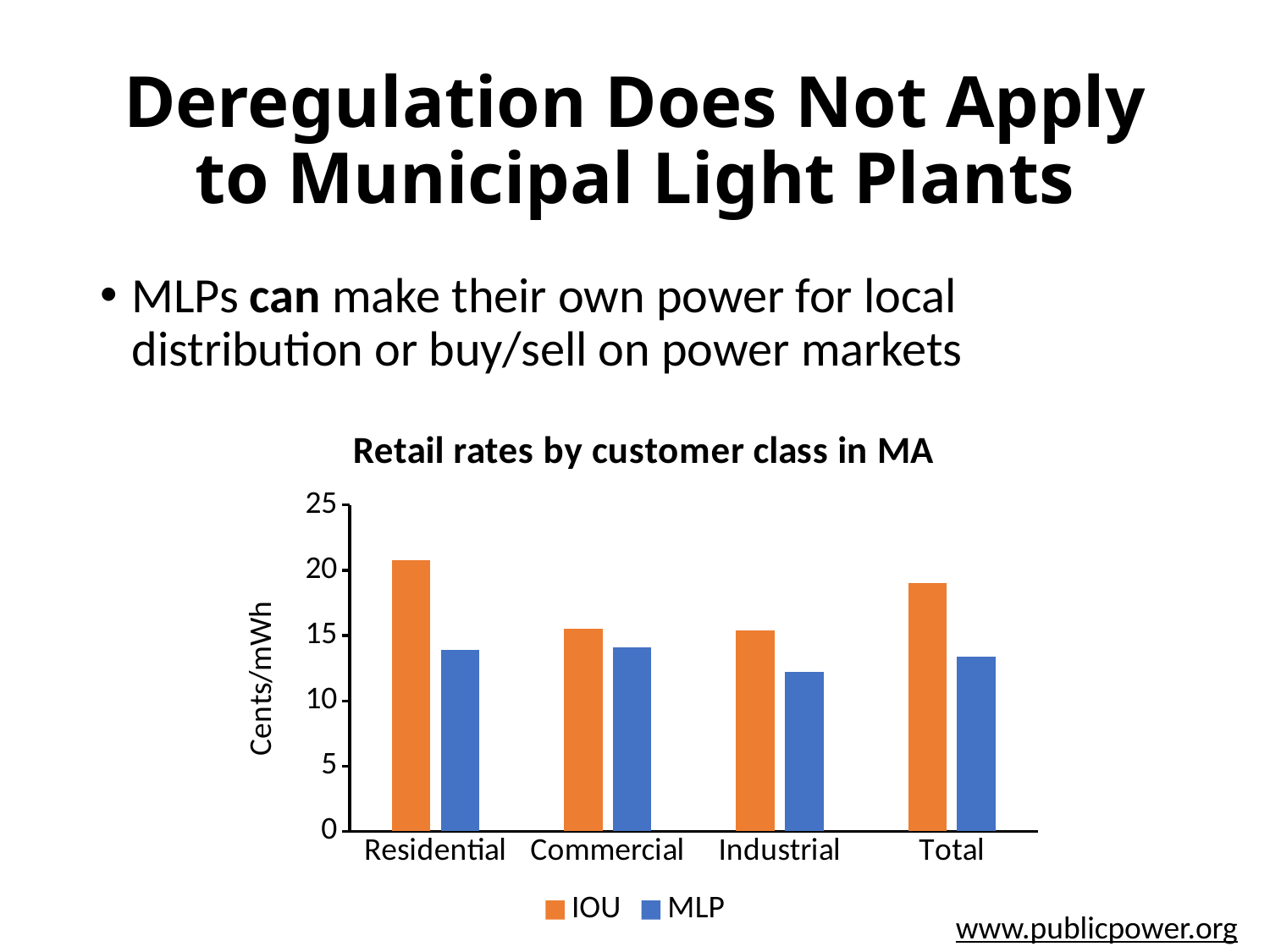
How many customer class categories are shown on the x axis? 4 How many series does the legend list? 2 What kind of chart is shown on the slide? bar chart What is the title of the chart? Retail rates by customer class in MA What unit is shown on the y axis label? Cents/mWh Which category has the highest IOU value? Residential Is the MLP value for Industrial greater or less than 15? less Which category has the lowest MLP value? Industrial Is the IOU value for Total greater or less than 15? greater For Total, which is larger, the IOU value or the MLP value? IOU For Residential, which is larger, the IOU value or the MLP value? IOU Is the IOU value for Residential greater or less than 20? greater